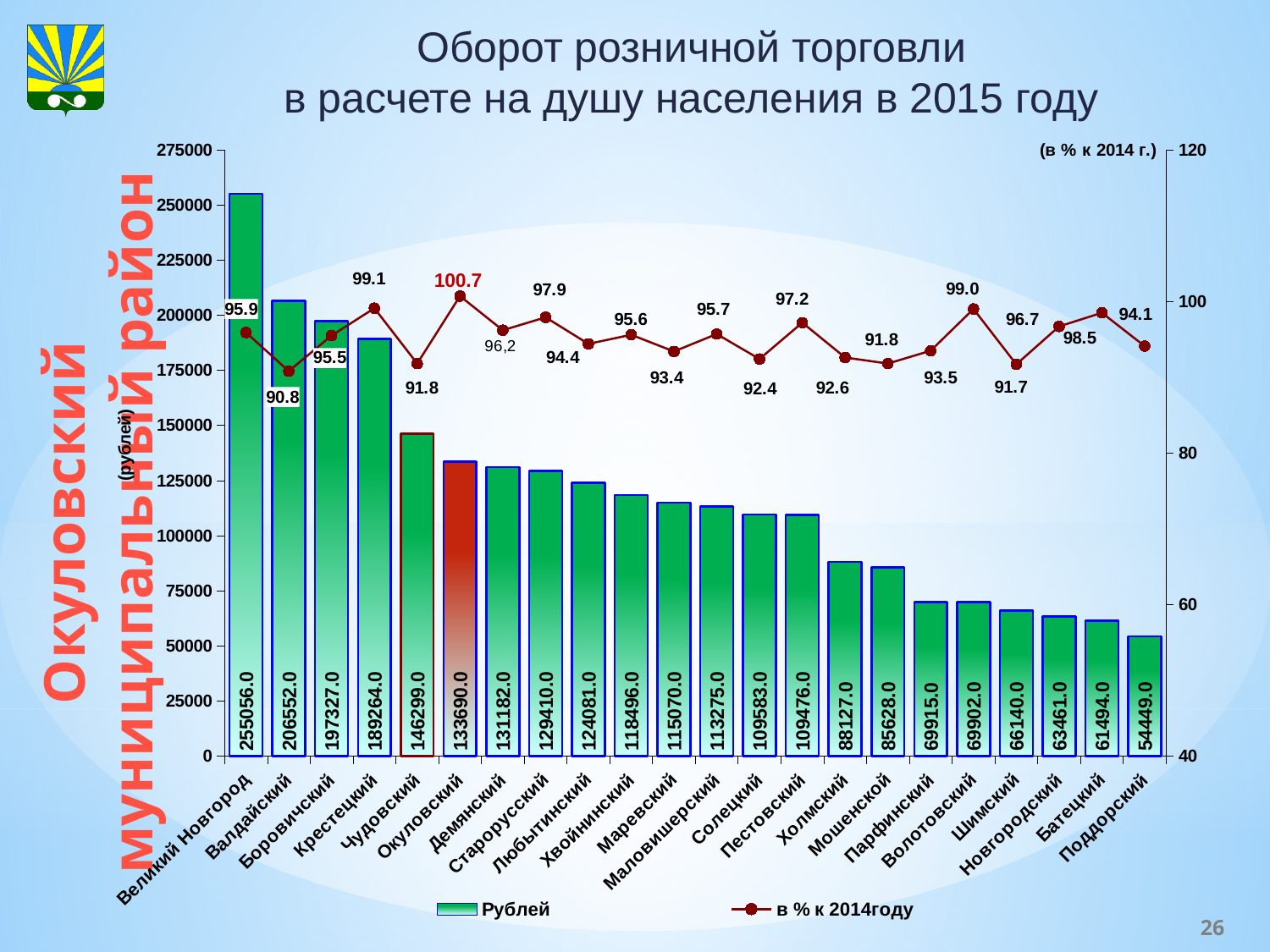
What is the value in rubles for Великий Новгород? 255056.0 What is the value of the 'в % к 2014году' line for Окуловский? 100.7 Which has a larger value in rubles, Чудовский or Демянский? Чудовский What is the difference in rubles between Великий Новгород and Валдайский? 48504.0 What is the value of the 'в % к 2014году' line for Валдайский? 90.8 Do the bar values in rubles rise or fall from left to right along the x axis? Fall Which category has the lowest value in rubles? Поддорский Which category has the highest value on the 'в % к 2014году' line? Окуловский What is the value in rubles for Окуловский? 133690.0 How many series does the legend list? 2 How many categories are shown on the x axis? 22 What kind of chart is this? Combined bar and line chart